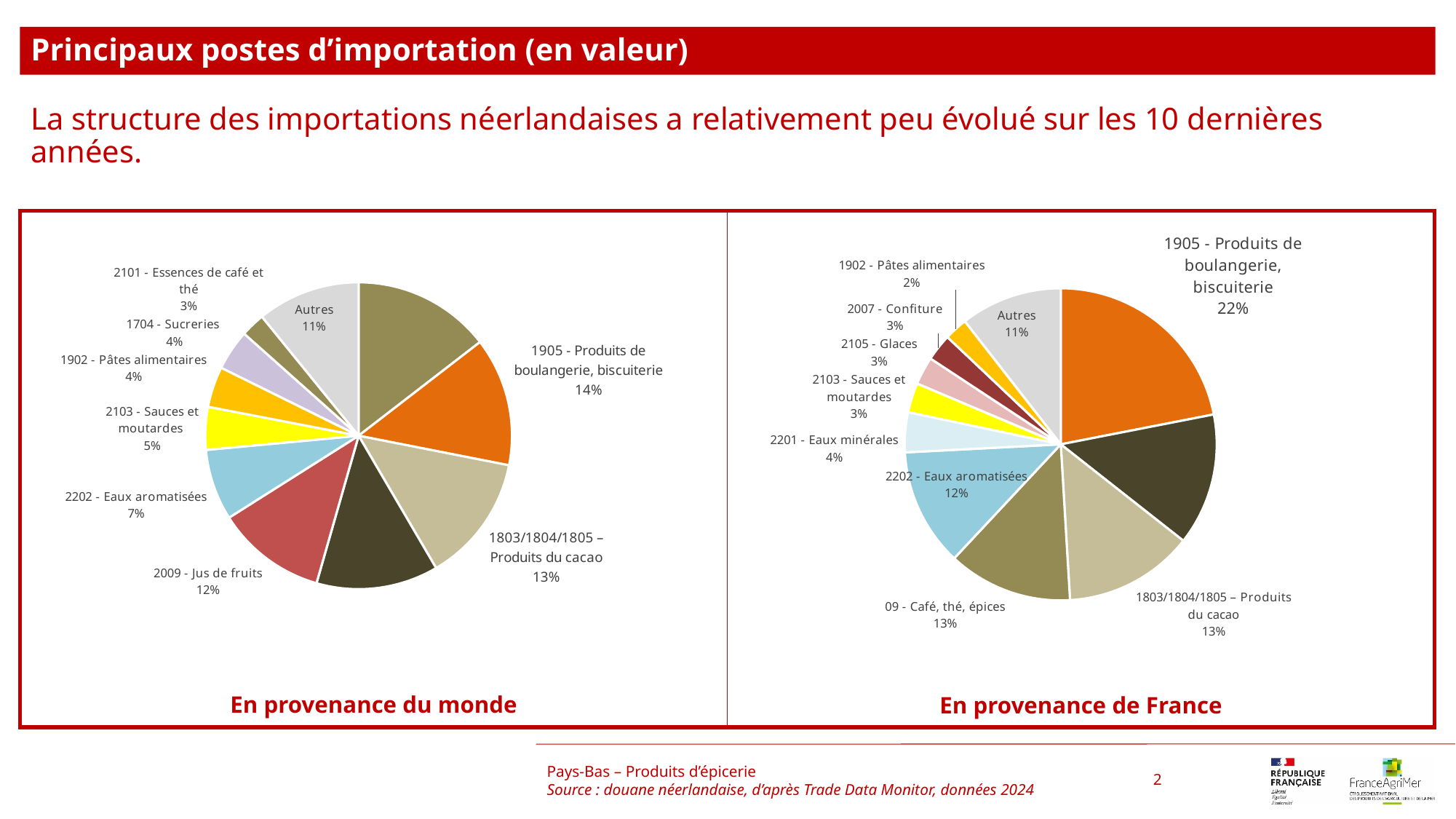
In the 'En provenance du monde' chart, which labelled category has the smallest share? 2101 - Essences de café et thé What is the title of the chart on the right side of the slide? En provenance de France In the 'En provenance du monde' chart, what share do 2202 - Eaux aromatisées represent? 7% In the 'En provenance de France' chart, which labelled category has the smallest share? 1902 - Pâtes alimentaires In the 'En provenance de France' chart, which is larger: the share of 2201 - Eaux minérales or the share of 2007 - Confiture? 2201 - Eaux minérales In the 'En provenance du monde' chart, what share do 1905 - Produits de boulangerie, biscuiterie represent? 14% In the 'En provenance de France' chart, what share do 2202 - Eaux aromatisées represent? 12% In the 'En provenance du monde' chart, what share do 2009 - Jus de fruits represent? 12% In the 'En provenance de France' chart, which labelled category has the largest share? 1905 - Produits de boulangerie, biscuiterie What kind of chart is used on this slide? Pie chart In the 'En provenance de France' chart, what share do 1905 - Produits de boulangerie, biscuiterie represent? 22% In the 'En provenance du monde' chart, what is the difference between the shares of 1905 - Produits de boulangerie, biscuiterie and 2103 - Sauces et moutardes? 9 percentage points